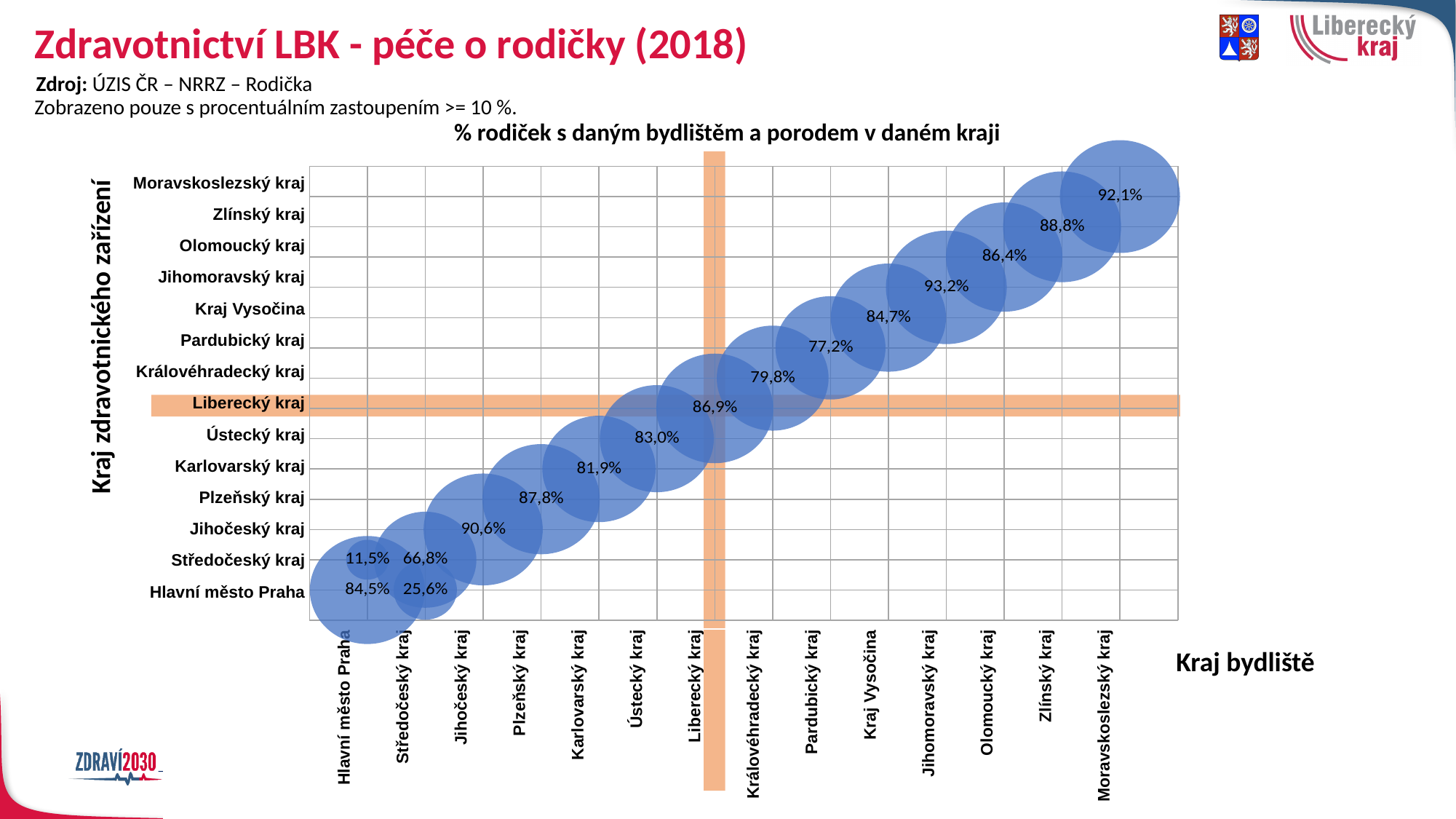
What is the difference between the value for Moravskoslezský kraj (92,1%) and Zlínský kraj (88,8%)? 3,3 percentage points What percentage is shown for mothers living in Hlavní město Praha who gave birth in Středočeský kraj? 11,5% What label is given to the vertical axis of the chart? Kraj zdravotnického zařízení How many regions (kraje) are listed along the x axis (Kraj bydliště)? 14 What is the chart's title? % rodiček s daným bydlištěm a porodem v daném kraji Which region has the highest percentage of mothers giving birth in their own region of residence? Jihomoravský kraj What kind of chart is shown on the slide? bubble chart What percentage is shown for mothers living in Liberecký kraj who gave birth in Liberecký kraj? 86,9% What percentage is shown for mothers living in Jihomoravský kraj who gave birth in Jihomoravský kraj? 93,2% Which region has the lowest percentage of mothers giving birth in their own region of residence? Středočeský kraj What percentage is shown for mothers living in Středočeský kraj who gave birth in Hlavní město Praha? 25,6% Which is larger: the value for Pardubický kraj or the value for Královéhradecký kraj? Královéhradecký kraj